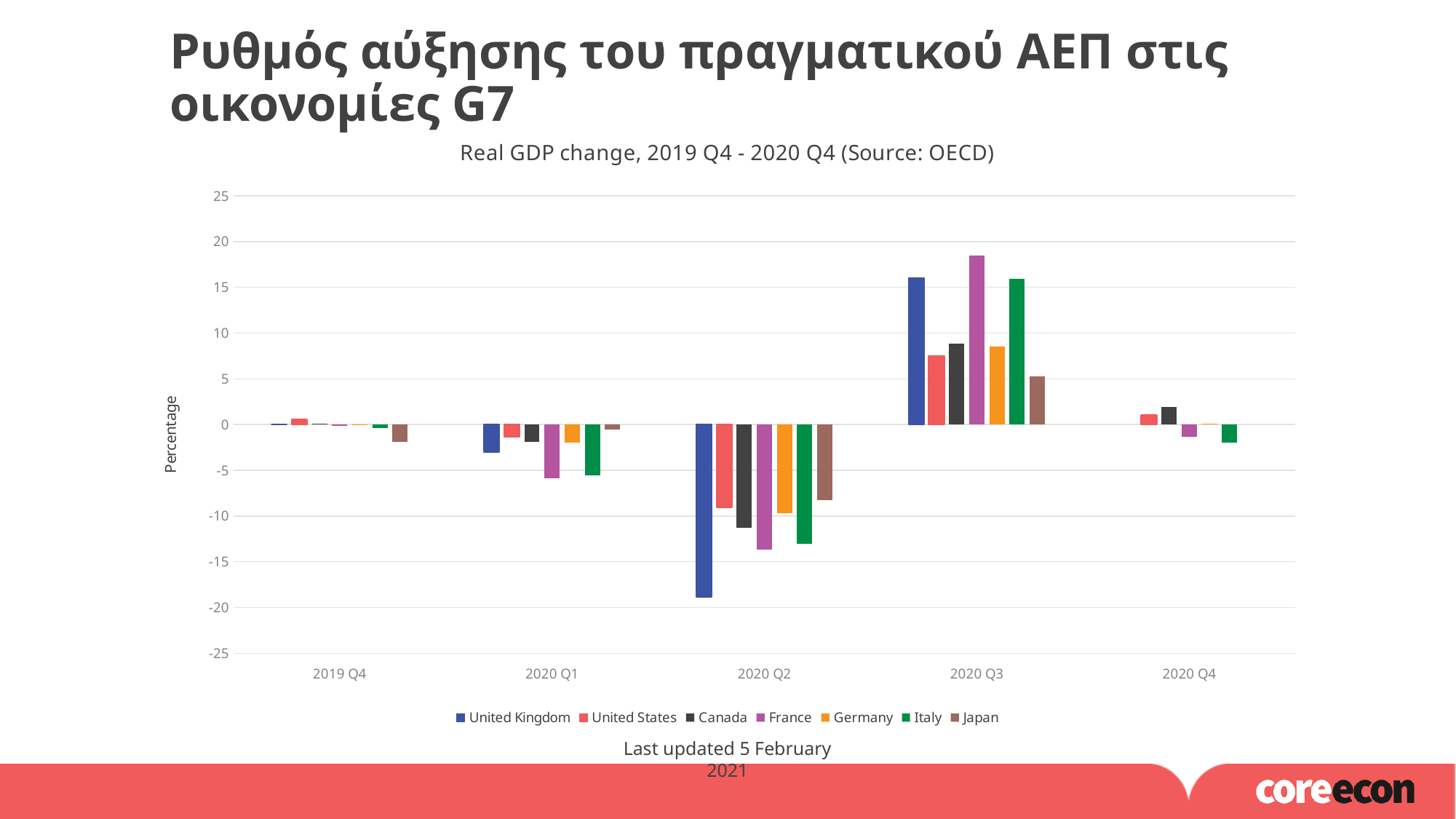
Is the value for France in 2020 Q3 greater or less than 15? greater What is the label on the y axis of the chart? Percentage Which country has the highest real GDP change in 2020 Q3? France Is the value for Japan in 2020 Q3 greater or less than 10? less In 2020 Q2, which has the lower value: Canada or the United States? Canada Is the value for the United Kingdom in 2020 Q2 greater or less than -15? less Which country has the lowest real GDP change in 2020 Q2? United Kingdom Which country has the lowest real GDP change in 2020 Q3? Japan What kind of chart is shown on the slide? bar chart How many series does the legend list? 7 In 2020 Q3, which has the larger value: the United Kingdom or Japan? United Kingdom How many quarters are shown along the x axis? 5